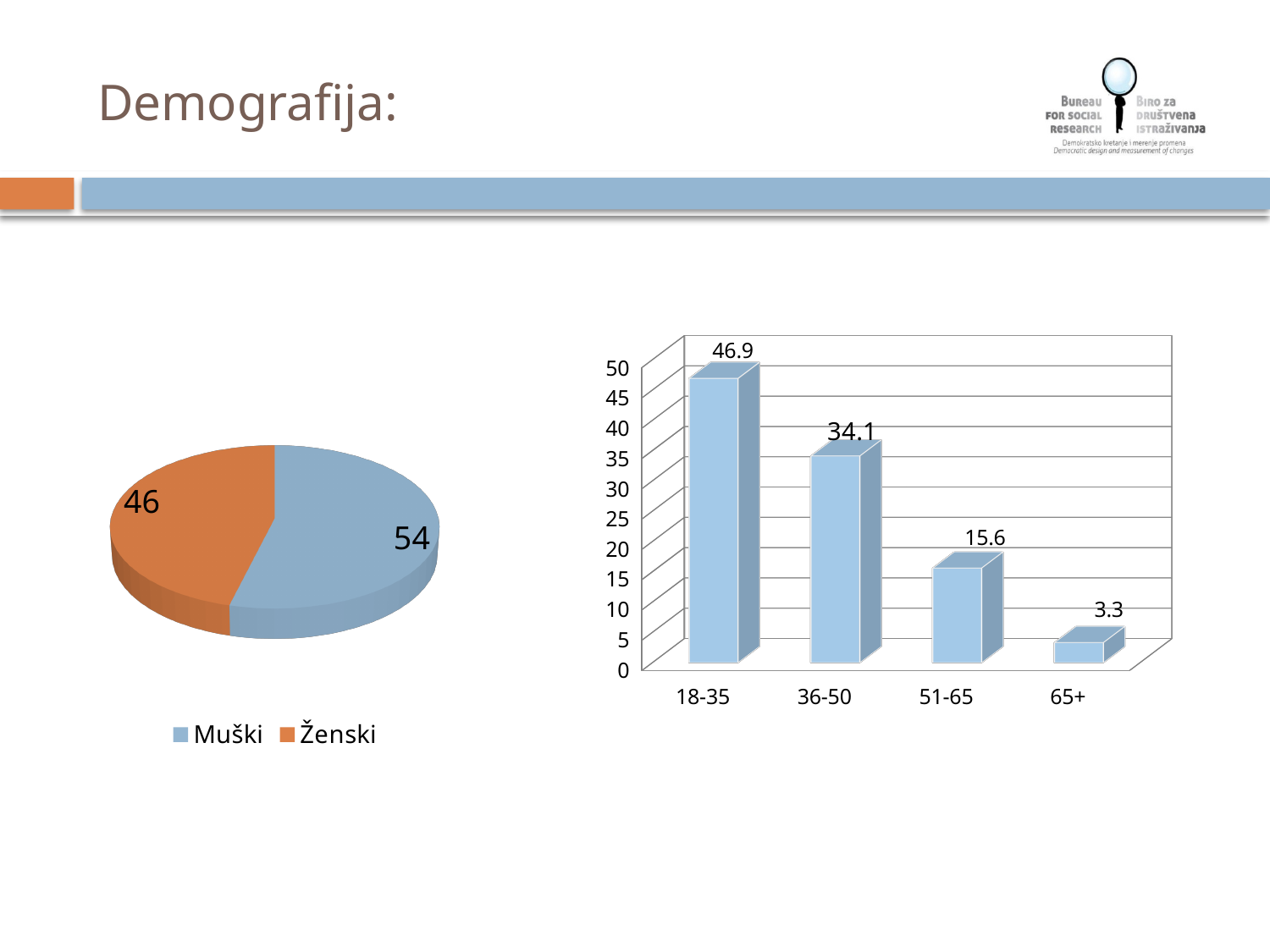
In the bar chart on the right, what is the difference between the 36-50 and 51-65 values? 18.5 In the bar chart on the right, what is the value for the 18-35 age group? 46.9 In the pie chart on the left, what is the difference between the Muški and Ženski values? 8 In the bar chart on the right, how many age groups are shown? 4 In the bar chart on the right, what is the value for the 65+ age group? 3.3 In the pie chart on the left, what is the value for Ženski? 46 In the pie chart on the left, what is the value for Muški? 54 In the pie chart on the left, how many entries does the legend list? 2 In the bar chart on the right, do the values rise or fall from left to right along the x axis? Fall In the pie chart on the left, which category has the larger slice? Muški In the bar chart on the right, which age group has the lowest value? 65+ In the pie chart on the left, what colour is the Ženski slice? Orange